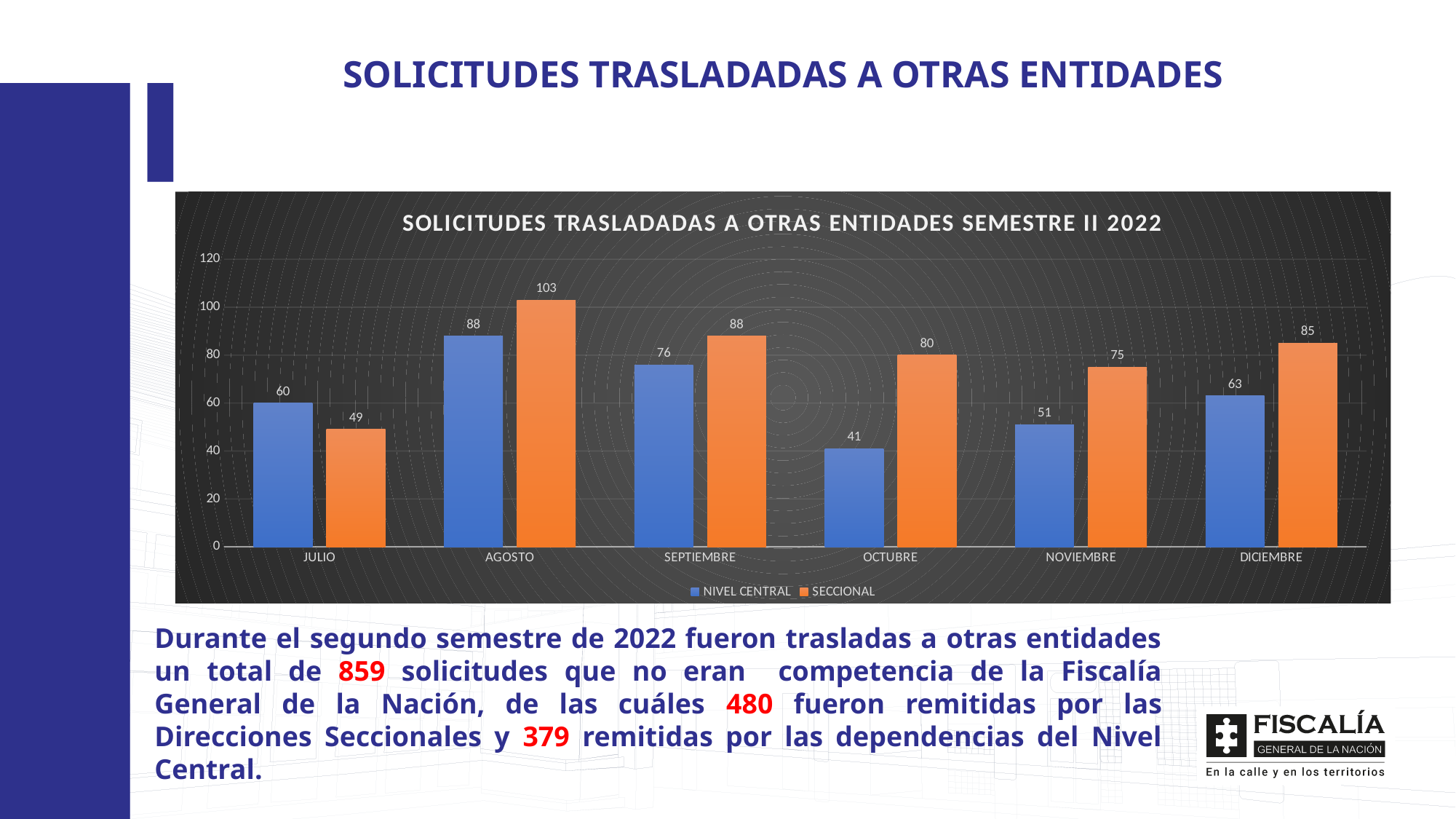
How many months are shown on the x axis? 6 Which is larger in JULIO, NIVEL CENTRAL or SECCIONAL? NIVEL CENTRAL What kind of chart is shown? bar chart Which month has the lowest NIVEL CENTRAL value? OCTUBRE Is the SECCIONAL value for SEPTIEMBRE greater or less than 80? greater What is the NIVEL CENTRAL value for DICIEMBRE? 63 What is the difference between the SECCIONAL and NIVEL CENTRAL values for NOVIEMBRE? 24 Which month has the highest SECCIONAL value? AGOSTO What is the SECCIONAL value for OCTUBRE? 80 What is the NIVEL CENTRAL value for AGOSTO? 88 What is the title of the chart? SOLICITUDES TRASLADADAS A OTRAS ENTIDADES SEMESTRE II 2022 How many series does the legend list? 2